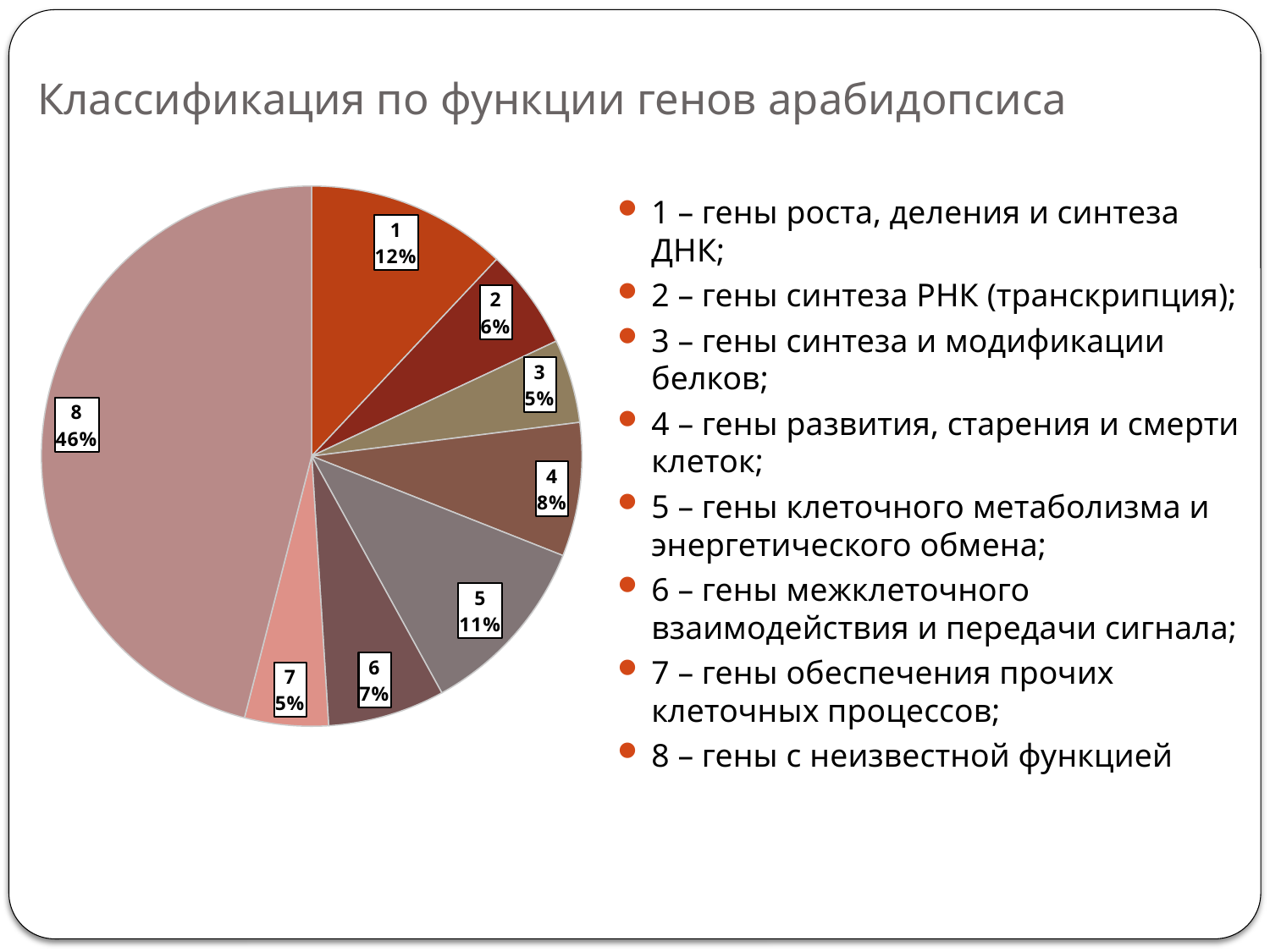
What is the difference in percentage points between slice 8 and slice 1? 34 Which slice has the largest share of the pie? 8 How many slices does the pie chart have? 8 What percentage is shown for slice 1? 12% What percentage is shown for slice 4? 8% What type of chart is shown on the slide? pie chart According to the slide's legend text, what does slice 8 represent? гены с неизвестной функцией What share of the pie does slice 8 represent? 46% What percentage is shown for slice 5? 11% Which slice is larger, slice 1 or slice 2? 1 What is the difference in percentage points between slice 5 and slice 6? 4 Which slices share the smallest percentage value, and what is it? 3 and 7, 5%